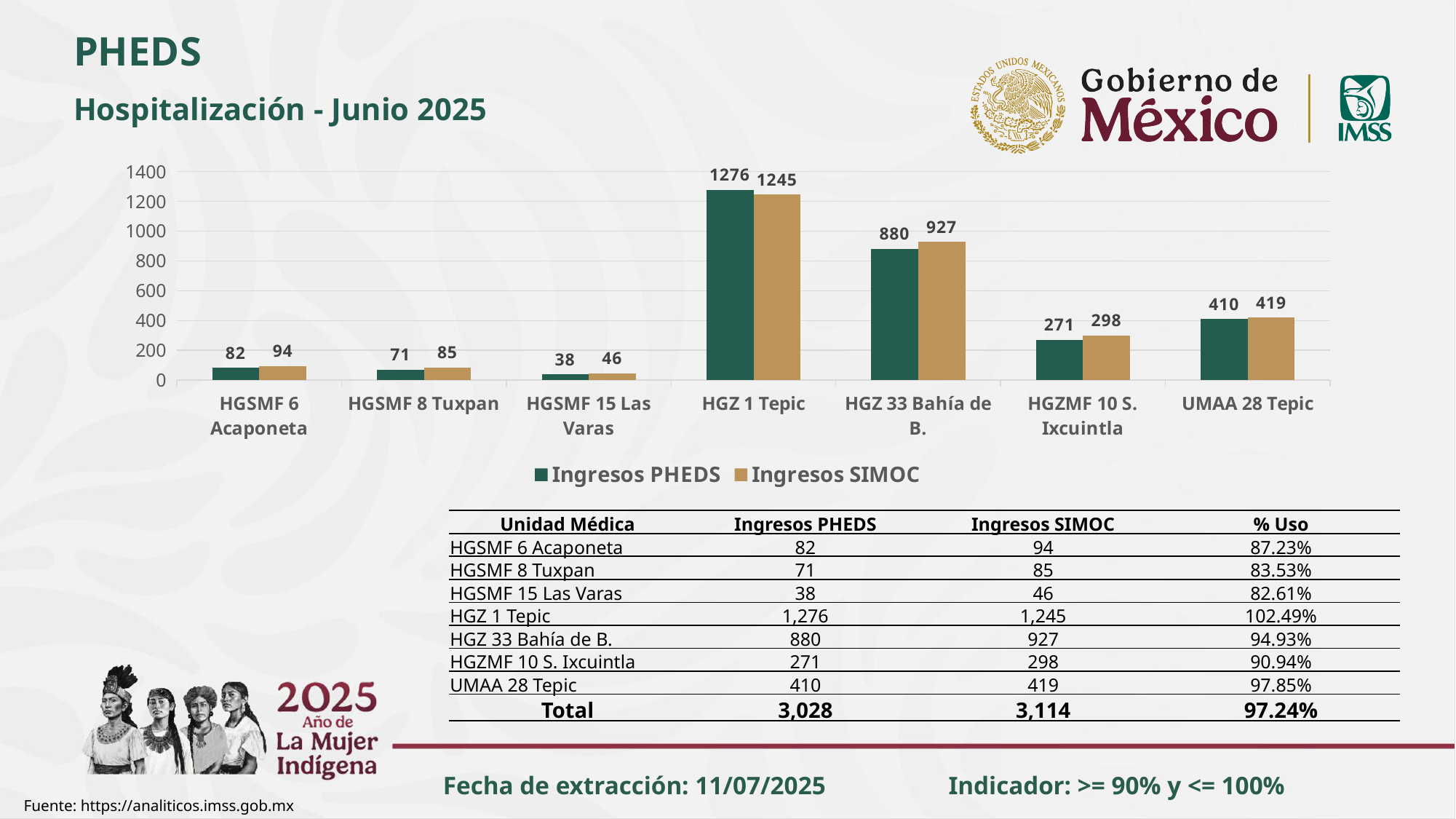
What kind of chart is shown on the slide? bar chart What is the Ingresos SIMOC value for HGZ 33 Bahía de B.? 927 For HGZ 1 Tepic, which is larger: Ingresos PHEDS or Ingresos SIMOC? Ingresos PHEDS What is the difference between Ingresos SIMOC and Ingresos PHEDS for HGZMF 10 S. Ixcuintla? 27 What is the Ingresos PHEDS value for HGZ 1 Tepic? 1276 How many categories are shown on the x axis of the chart? 7 Which category has the highest Ingresos SIMOC value? HGZ 1 Tepic How many series does the chart legend list? 2 What is the Ingresos PHEDS value for HGSMF 15 Las Varas? 38 Which category has the lowest Ingresos PHEDS value? HGSMF 15 Las Varas Is the Ingresos PHEDS value for UMAA 28 Tepic greater or less than 600? less What are the two series named in the chart legend? Ingresos PHEDS and Ingresos SIMOC